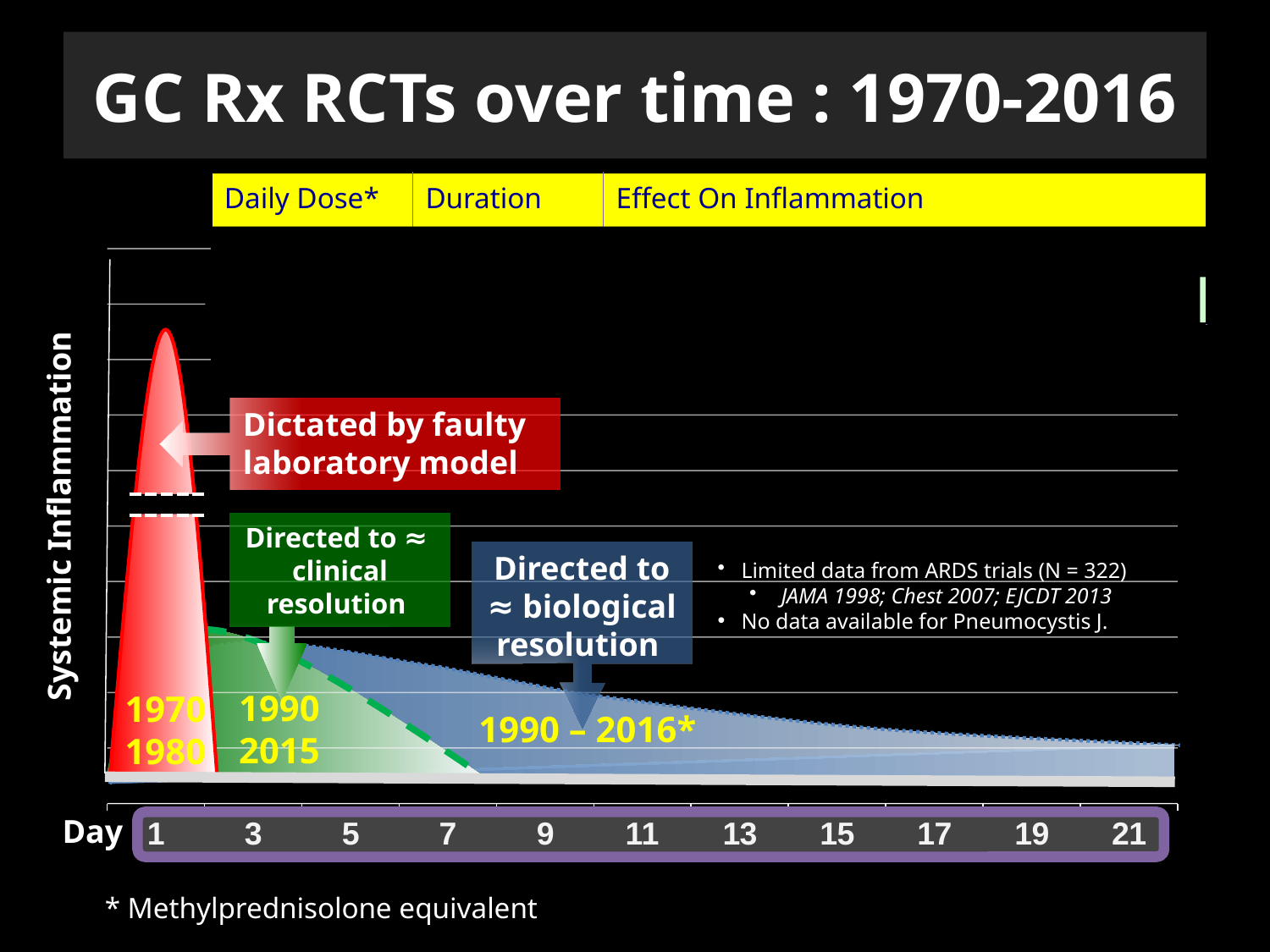
What colour is the 1970-1980 region of the chart? red Which era's curve extends furthest along the Day axis? 1990 – 2016* Which era's curve covers the shortest span of days? 1970-1980 What is the first day value shown on the horizontal axis? 1 How many day labels are shown along the horizontal axis? 11 What kind of chart is shown on the slide? area chart Which curve peaks higher, the 1970-1980 curve or the 1990-2015 curve? 1970-1980 Does the 1990 – 2016* curve rise or fall as the days increase from day 7 to day 21? fall Which era's curve reaches the highest level of systemic inflammation? 1970-1980 What label is shown on the vertical axis of the chart? Systemic Inflammation What is the last day value shown on the horizontal axis? 21